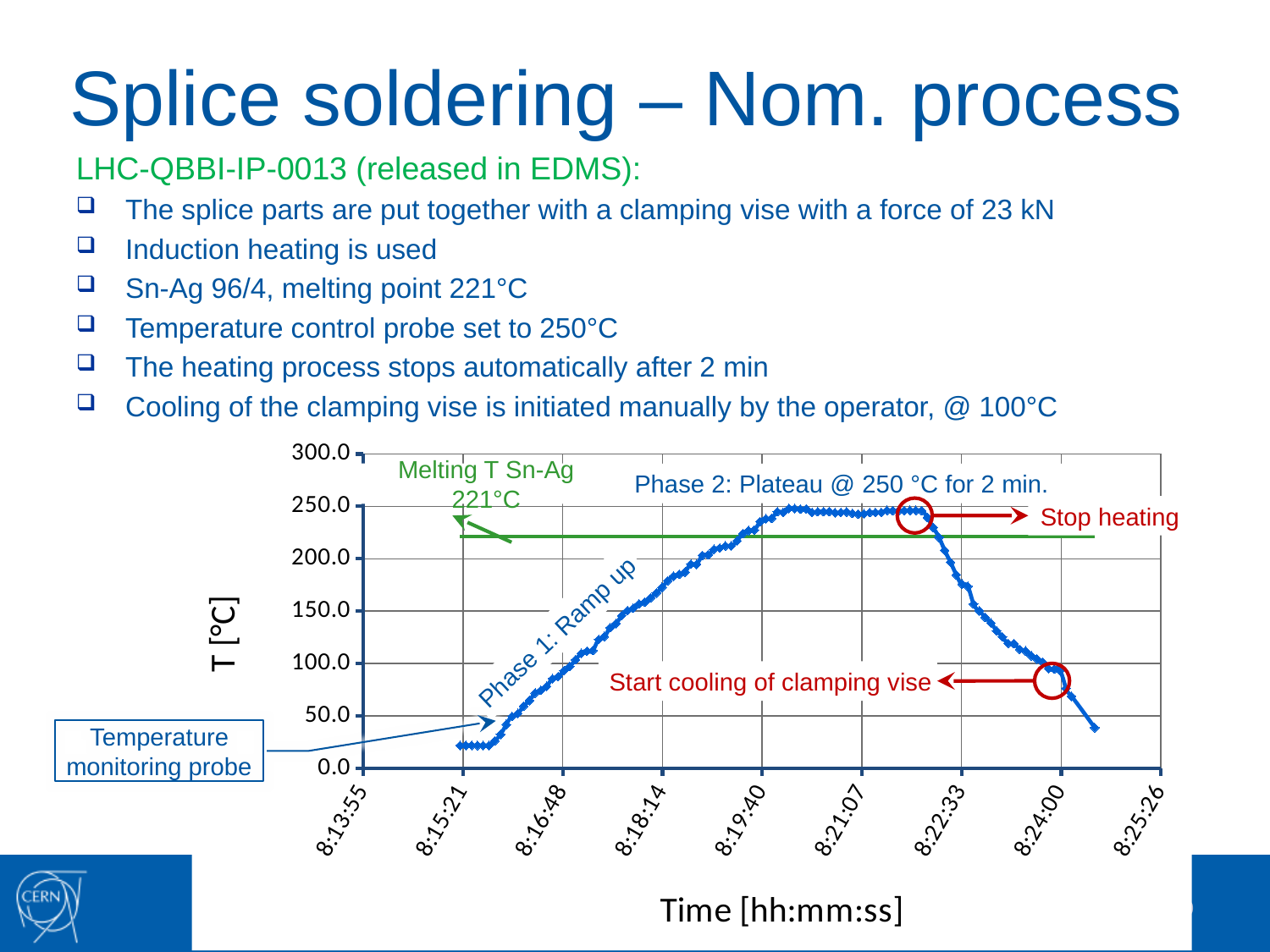
What is the highest value printed on the temperature axis? 300.0 Is the temperature at 8:24:00 greater or less than 150? less How many time labels are printed along the x axis of the chart? 9 Is the peak temperature reached by the curve greater or less than 300? less What label is attached to the first red circle on the curve, at the end of the plateau? Stop heating Is the temperature at 8:15:21 greater or less than 50? less Does the temperature rise or fall between 8:15:21 and 8:21:07? rise What is the title of the vertical axis of the chart? T [°C] What kind of chart is shown on the slide? line chart Does the temperature rise or fall between 8:22:33 and 8:25:26? fall